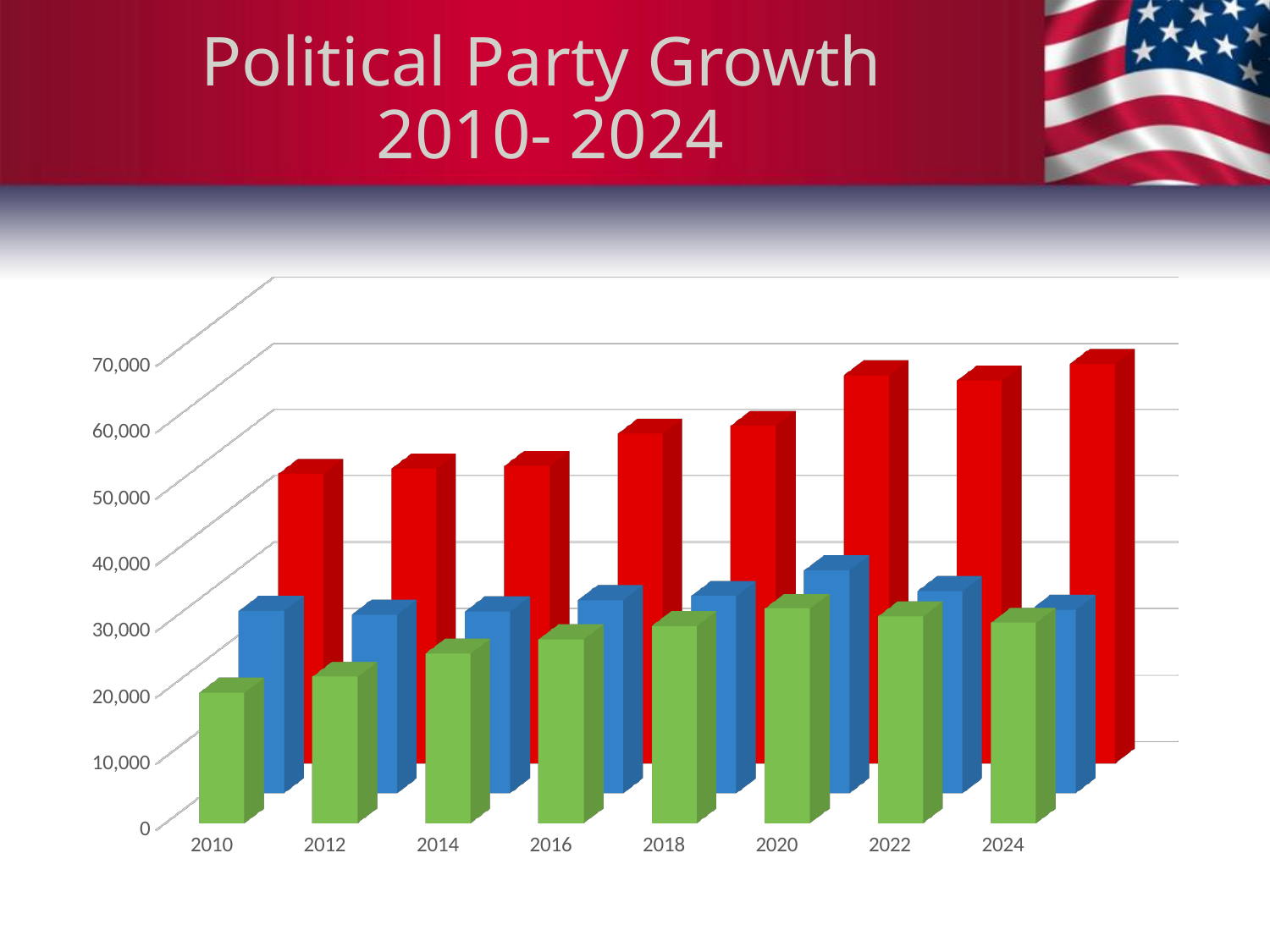
Which year has the lowest green bar? 2010 How many bars are shown for each year in the chart? 3 How many years are shown along the x axis of the chart? 8 Is the value of the red bar for 2010 greater or less than 40,000? greater Which is larger, the green bar for 2010 or the green bar for 2024? 2024 Do the red bars generally rise or fall from 2010 to 2024? rise In 2010, which is larger, the red bar or the green bar? the red bar What is the title of the chart on the slide? Political Party Growth 2010- 2024 What kind of chart is shown on the slide? bar chart Is the value of the green bar for 2010 greater or less than 30,000? less In 2010, which is larger, the blue bar or the green bar? the blue bar Which year has the highest blue bar? 2020